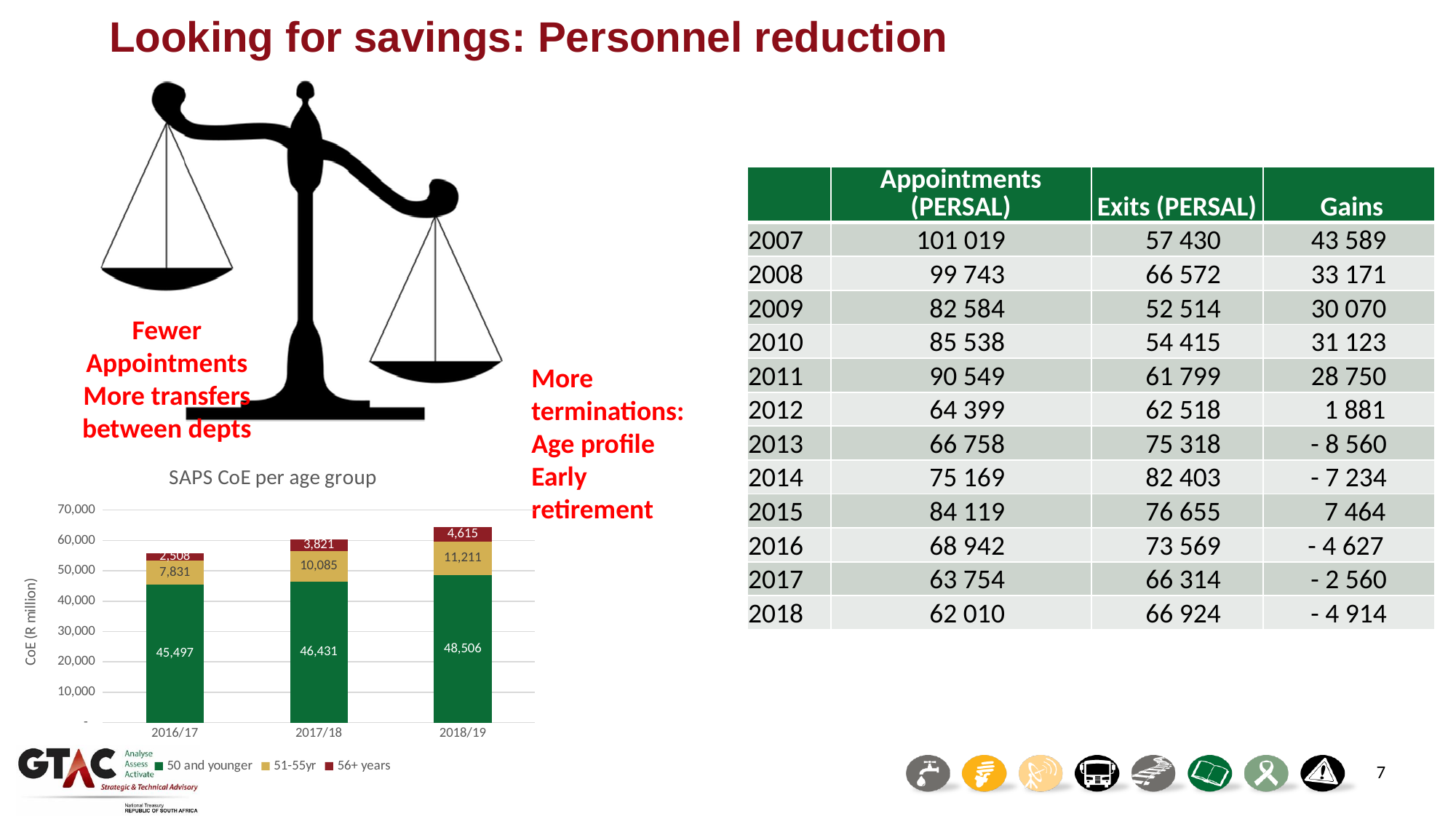
How many years are shown on the x axis of the 'SAPS CoE per age group' chart? 3 In the 'SAPS CoE per age group' chart, is the '51-55yr' value larger in 2017/18 or in 2018/19? 2018/19 In the 'SAPS CoE per age group' chart, what is the value for '51-55yr' in 2018/19? 11,211 In the 'SAPS CoE per age group' chart, what is the total of the stacked bar for 2018/19? 64,332 What kind of chart is 'SAPS CoE per age group'? Stacked bar chart In the 'SAPS CoE per age group' chart, what is the value for '56+ years' in 2016/17? 2,508 In the 'SAPS CoE per age group' chart, what is the value for '50 and younger' in 2017/18? 46,431 In the 'SAPS CoE per age group' chart, what is the difference between the '50 and younger' values for 2018/19 and 2016/17? 3,009 In the 'SAPS CoE per age group' chart, which year has the highest value for '56+ years'? 2018/19 How many series does the legend of the 'SAPS CoE per age group' chart list? 3 In the 'SAPS CoE per age group' chart, what is the total of the stacked bar for 2016/17? 55,836 In the 'SAPS CoE per age group' chart, which year has the lowest value for '51-55yr'? 2016/17